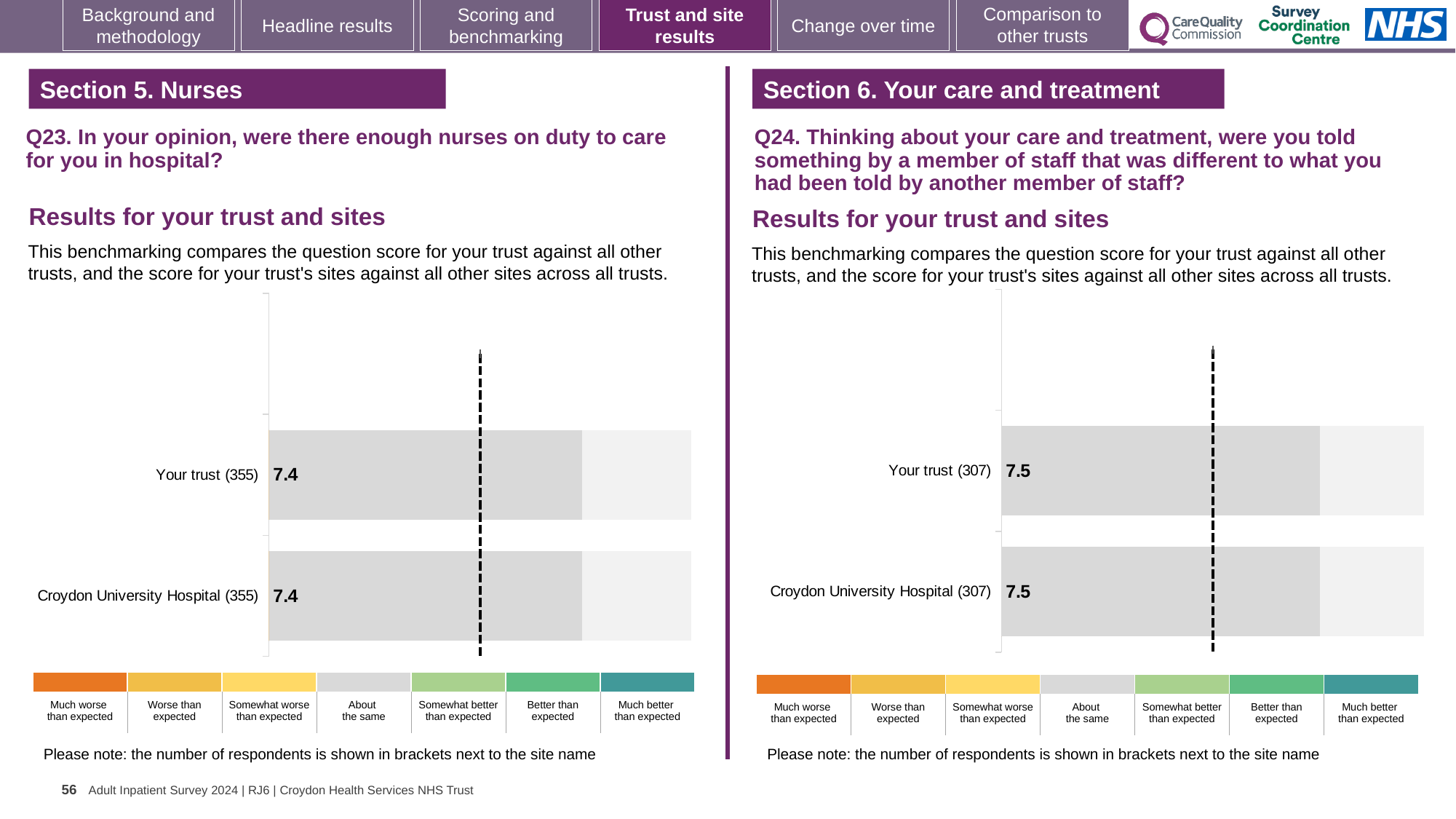
On the Q24 chart (right), how many respondents are shown in brackets next to Croydon University Hospital? 307 How many bars are plotted on the Q23 chart (left)? 2 How many bars are plotted on the Q24 chart (right)? 2 On the Q24 chart (right), what is the score for Croydon University Hospital (307)? 7.5 On the Q23 chart (left), how many respondents are shown in brackets next to Your trust? 355 On the Q23 chart (left), what is the difference between the score for Your trust (355) and the score for Croydon University Hospital (355)? 0 What kind of chart is the Q23 chart (left)? Bar chart On the Q23 chart (left), what is the score for Croydon University Hospital (355)? 7.4 On the Q23 chart (left), what is the score for Your trust (355)? 7.4 On the Q24 chart (right), what is the score for Your trust (307)? 7.5 On the Q24 chart (right), what is the difference between the score for Your trust (307) and the score for Croydon University Hospital (307)? 0